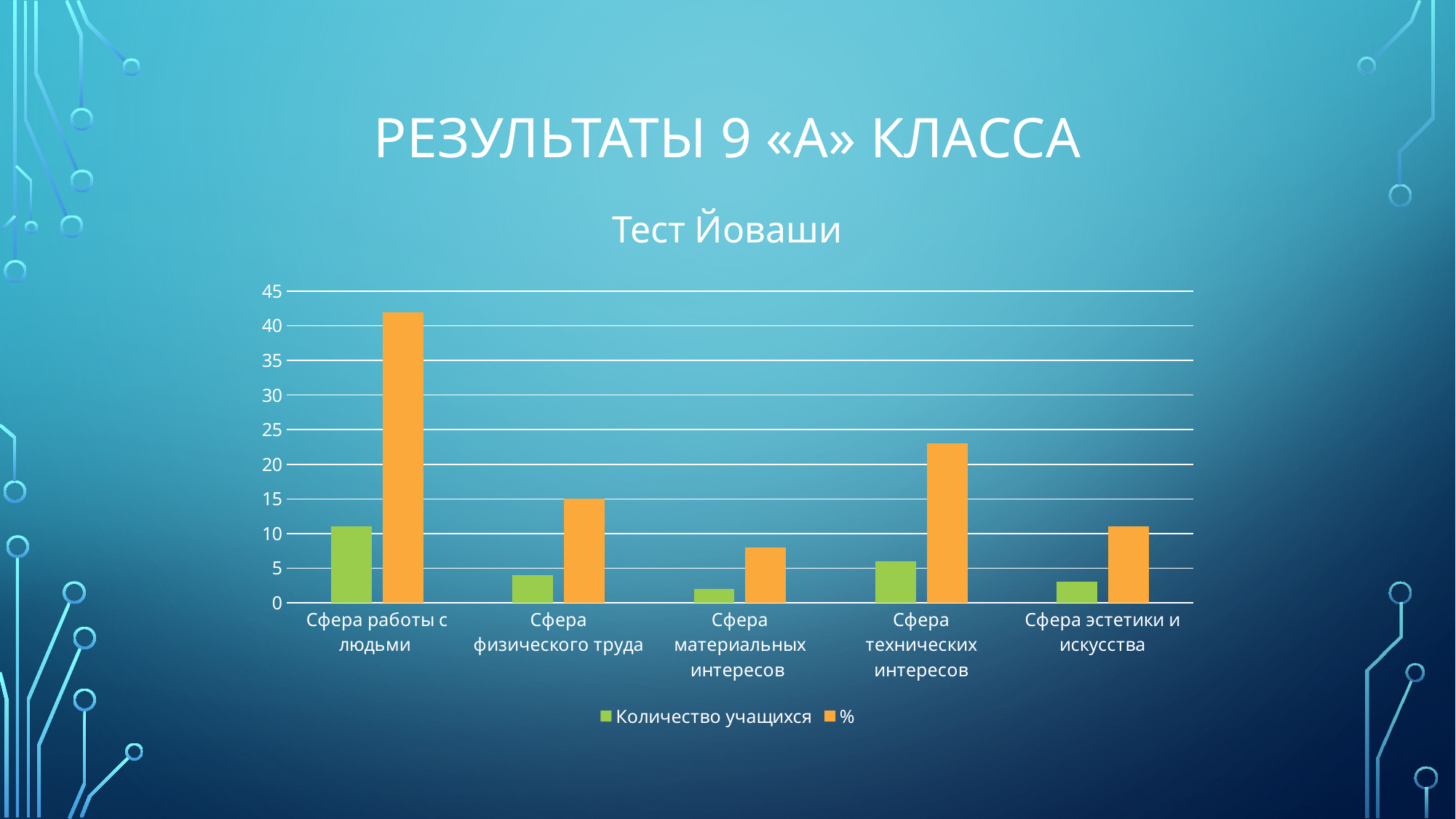
What is the title of the chart? Тест Йоваши Which category has the lowest value for the Количество учащихся series? Сфера материальных интересов What kind of chart is shown on the slide? bar chart Is the Количество учащихся value for Сфера материальных интересов greater or less than 5? less How many categories are shown on the x axis? 5 Is the % value for Сфера технических интересов greater or less than 20? greater Which category has the highest value for the % series? Сфера работы с людьми What is the % value for Сфера физического труда? 15 How many series does the legend list? 2 Which colour represents the % series in the legend? orange Is the % value for Сфера работы с людьми greater or less than 40? greater Which is larger: the % value for Сфера технических интересов or the % value for Сфера эстетики и искусства? Сфера технических интересов